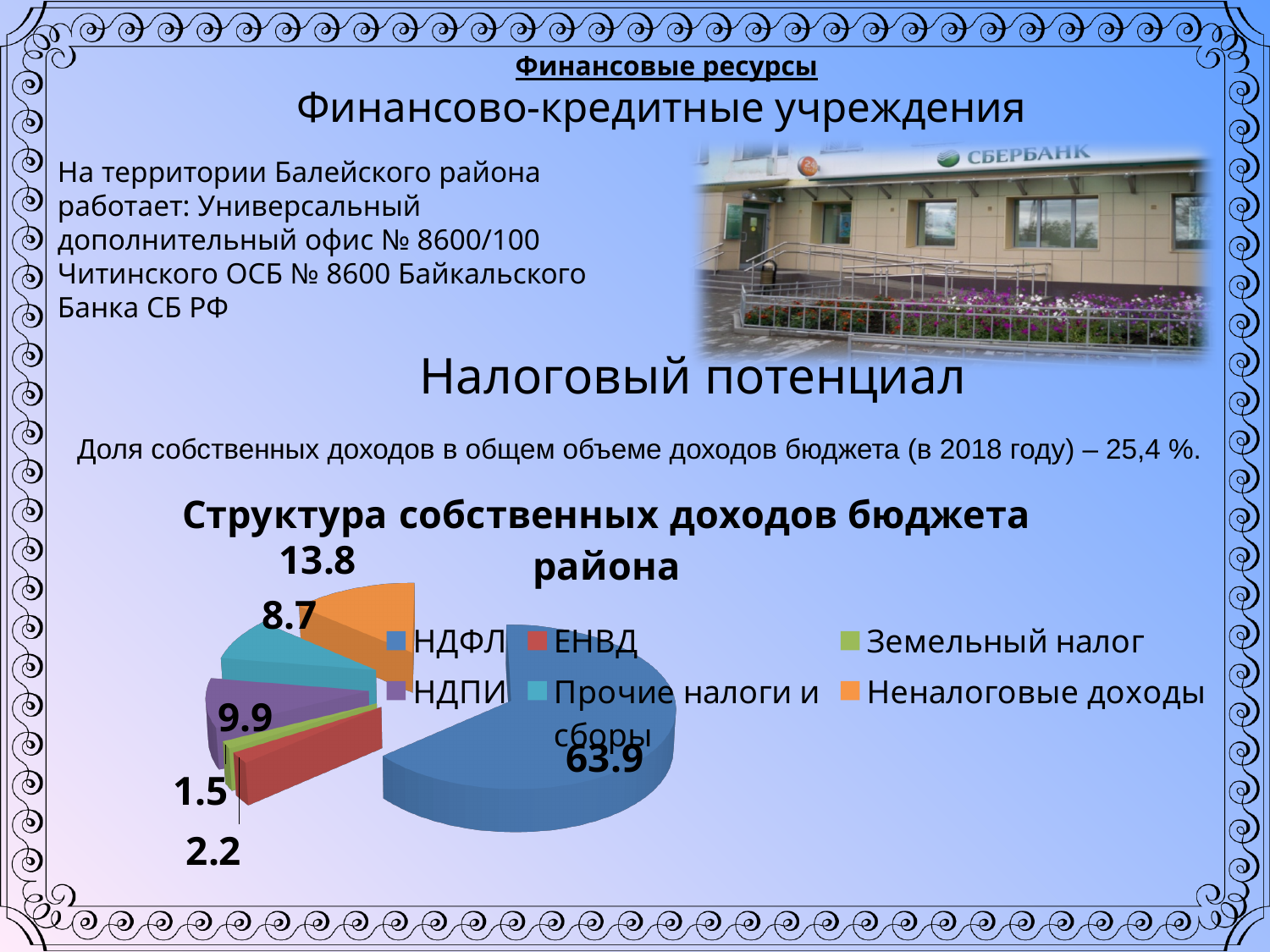
Which is larger in the pie chart, НДПИ or Прочие налоги и сборы? НДПИ How many categories does the legend of the pie chart list? 6 What is the value shown for Прочие налоги и сборы in the pie chart? 8.7 Which category has the smallest slice of the pie chart? Земельный налог What kind of chart is shown on the slide? pie chart Which category has the largest slice of the pie chart? НДФЛ What is the title of the chart? Структура собственных доходов бюджета района What is the difference between the values for НДФЛ and Неналоговые доходы? 50.1 What is the value shown for Неналоговые доходы in the pie chart? 13.8 What is the value shown for НДПИ in the pie chart? 9.9 What is the value shown for НДФЛ in the pie chart? 63.9 What is the value shown for Земельный налог in the pie chart? 1.5